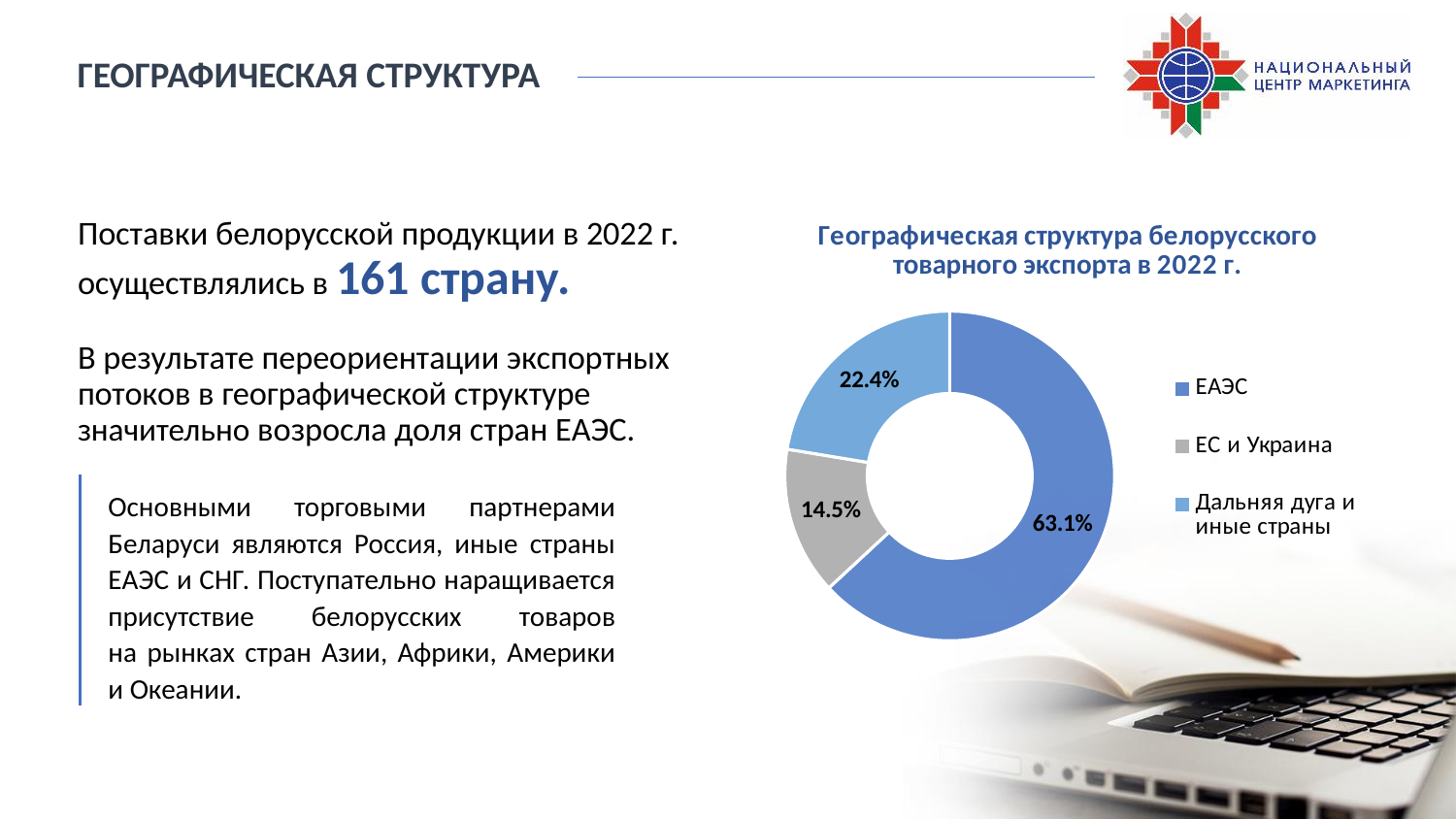
What share of Belarusian goods exports in 2022 went to ЕАЭС according to the chart? 63.1% Which category has the smallest share in the chart? ЕС и Украина How many categories are shown in the chart? 3 Which category has the largest share in the chart? ЕАЭС What type of chart is shown on the slide? Doughnut chart What share of the chart is labelled for ЕС и Украина? 14.5% What is the difference in percentage points between the Дальняя дуга и иные страны share and the ЕС и Украина share? 7.9 How many entries does the chart legend list? 3 What is the title of the chart on the slide? Географическая структура белорусского товарного экспорта в 2022 г. What is the difference in percentage points between the ЕАЭС share and the Дальняя дуга и иные страны share? 40.7 What percentage does the chart show for Дальняя дуга и иные страны? 22.4% Which is larger: the share for ЕС и Украина or the share for Дальняя дуга и иные страны? Дальняя дуга и иные страны